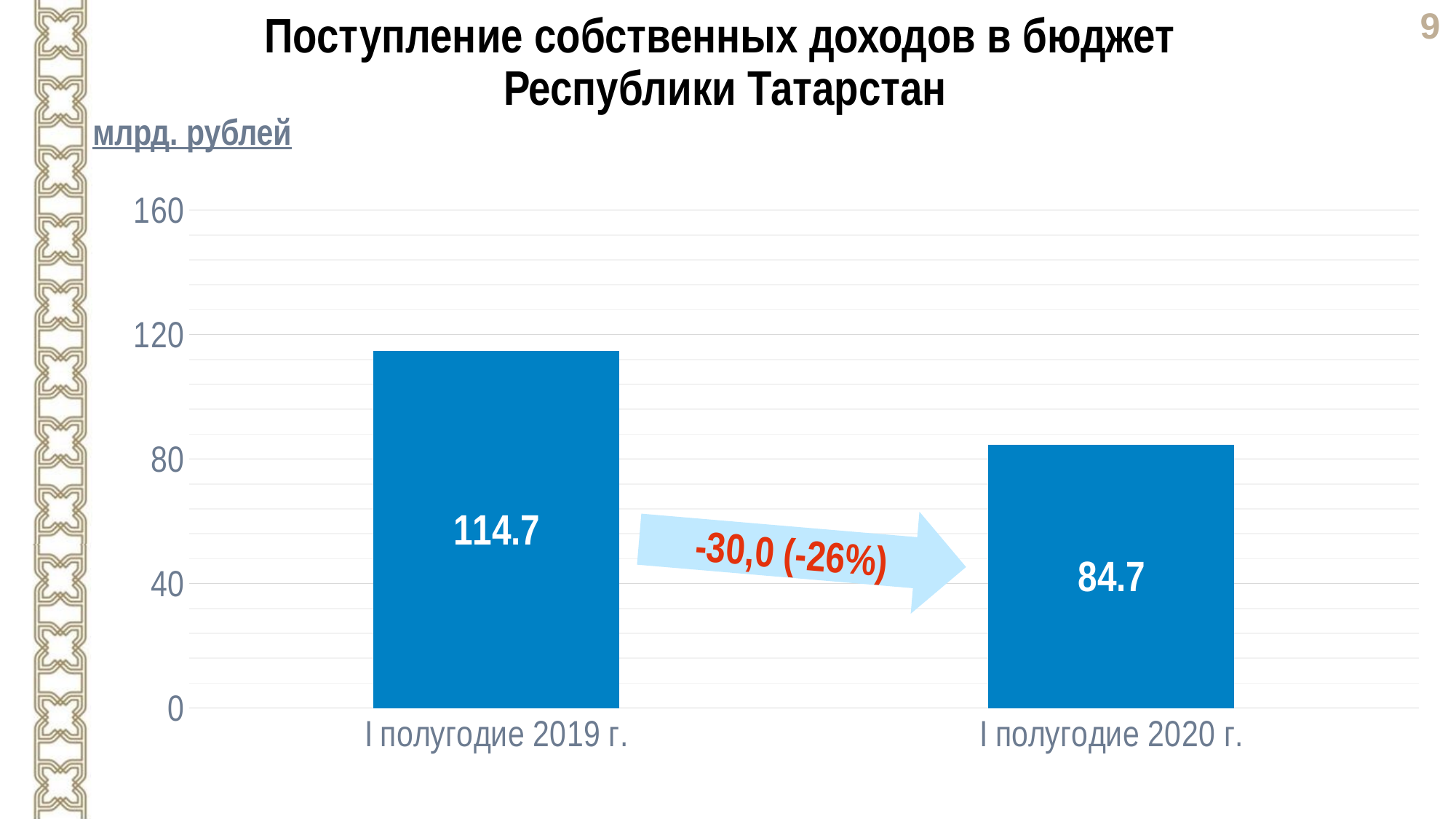
What kind of chart is shown on the slide? bar chart How many categories are shown on the x axis? 2 Is the value for I полугодие 2019 г. greater or less than 80? greater Which category has the highest value? I полугодие 2019 г. Which is larger, the value for I полугодие 2019 г. or I полугодие 2020 г.? I полугодие 2019 г. Is the value for I полугодие 2020 г. greater or less than 120? less Do the values rise or fall from I полугодие 2019 г. to I полугодие 2020 г.? fall What change is written on the arrow between the two bars? -30,0 (-26%) What is the difference between the values for I полугодие 2019 г. and I полугодие 2020 г.? 30.0 Which category has the lowest value? I полугодие 2020 г. What is the value for I полугодие 2020 г.? 84.7 What is the value for I полугодие 2019 г.? 114.7